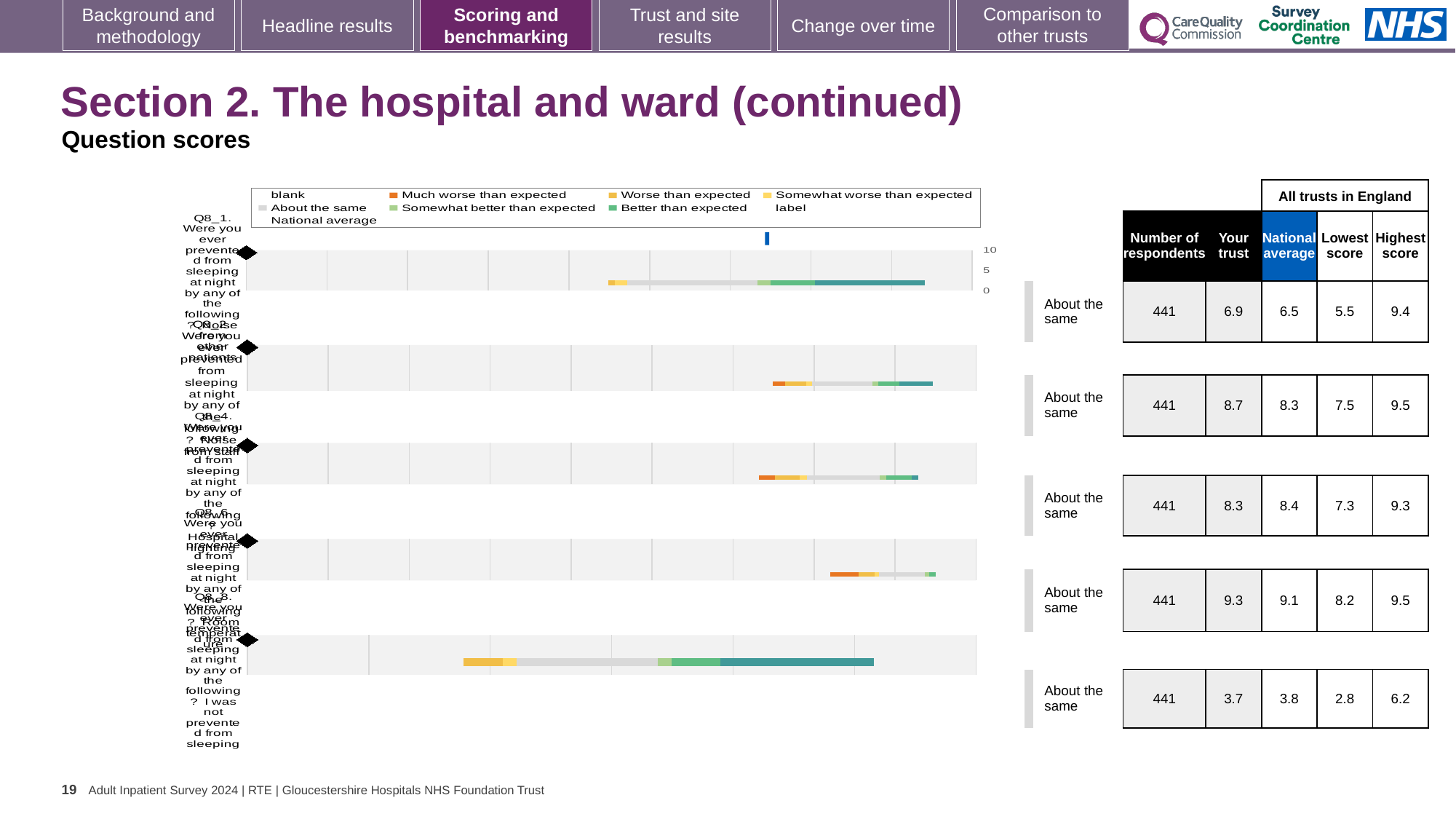
How many respondents are listed for each row of the chart? 441 Which row has the highest 'Your trust' score? the fourth row from the top (9.3) How many question rows (bars) are plotted in the chart? 5 What kind of chart is shown on the slide? bar chart What colour does the legend use for 'Much worse than expected'? orange What is the 'Your trust' score for the top row of the chart? 6.9 For the second row from the top, which is larger: the 'Your trust' score or the national average? Your trust (8.7) For the top row, what is the difference between the 'Your trust' score and the national average? 0.4 What benchmark label is shown next to every bar in the chart? About the same Which row has the lowest 'Your trust' score? the bottom row (3.7) What is the 'Your trust' score for the bottom row of the chart? 3.7 What is the national average for the top row of the chart? 6.5